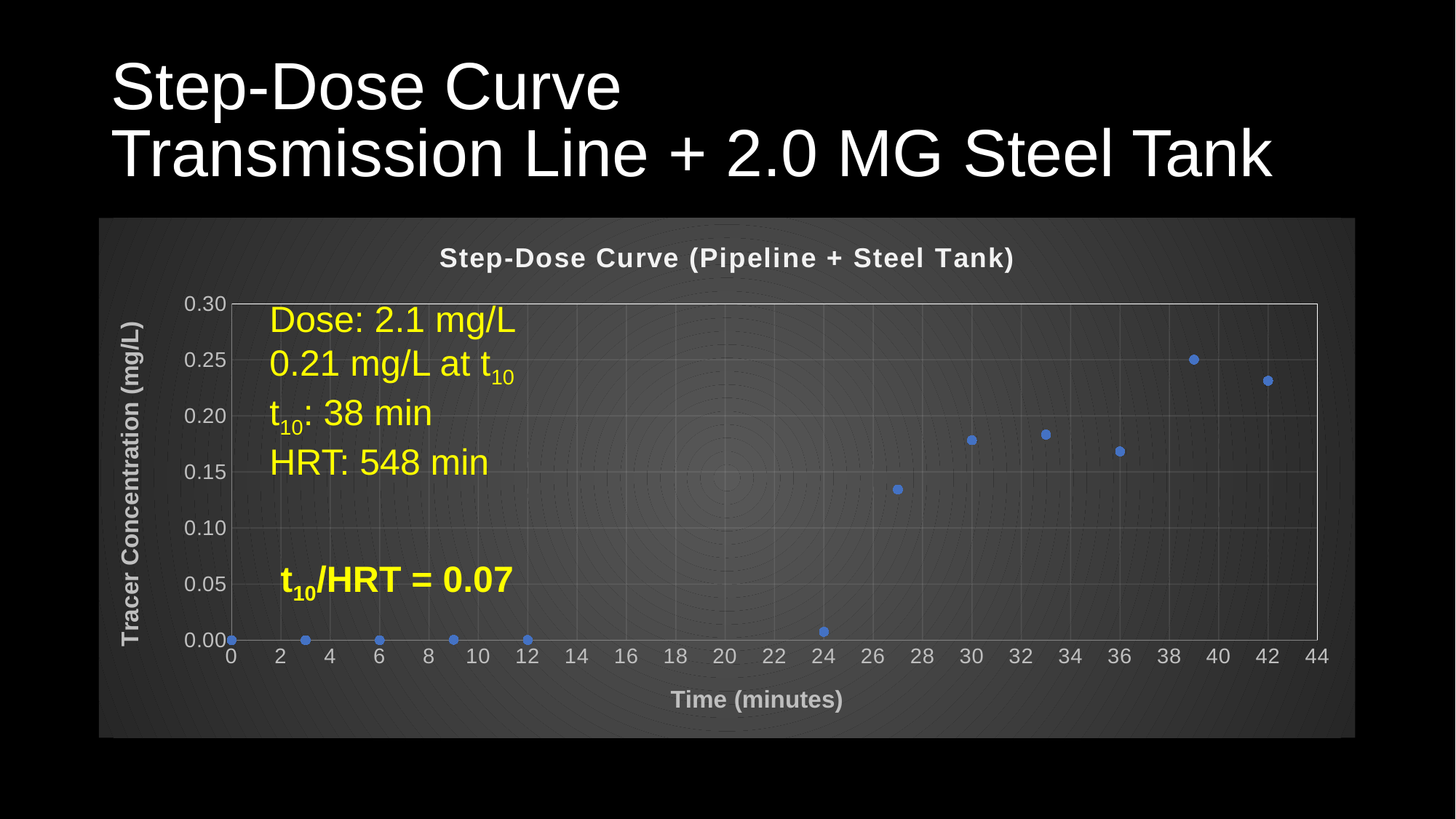
Is the tracer concentration at 42 minutes greater or less than 0.20? greater Is the tracer concentration at 27 minutes greater or less than 0.15? less What HRT value is annotated on the chart? 548 min What is the tracer concentration at 6 minutes? 0.00 At which time is the tracer concentration highest? 39 What is the title of the chart? Step-Dose Curve (Pipeline + Steel Tank) Which has the larger tracer concentration, 27 minutes or 30 minutes? 30 minutes Is the tracer concentration at 30 minutes greater or less than 0.15? greater What kind of chart is shown on the slide? scatter chart Do the tracer concentration values generally rise or fall as time increases? rise What is the tracer concentration at 39 minutes? 0.25